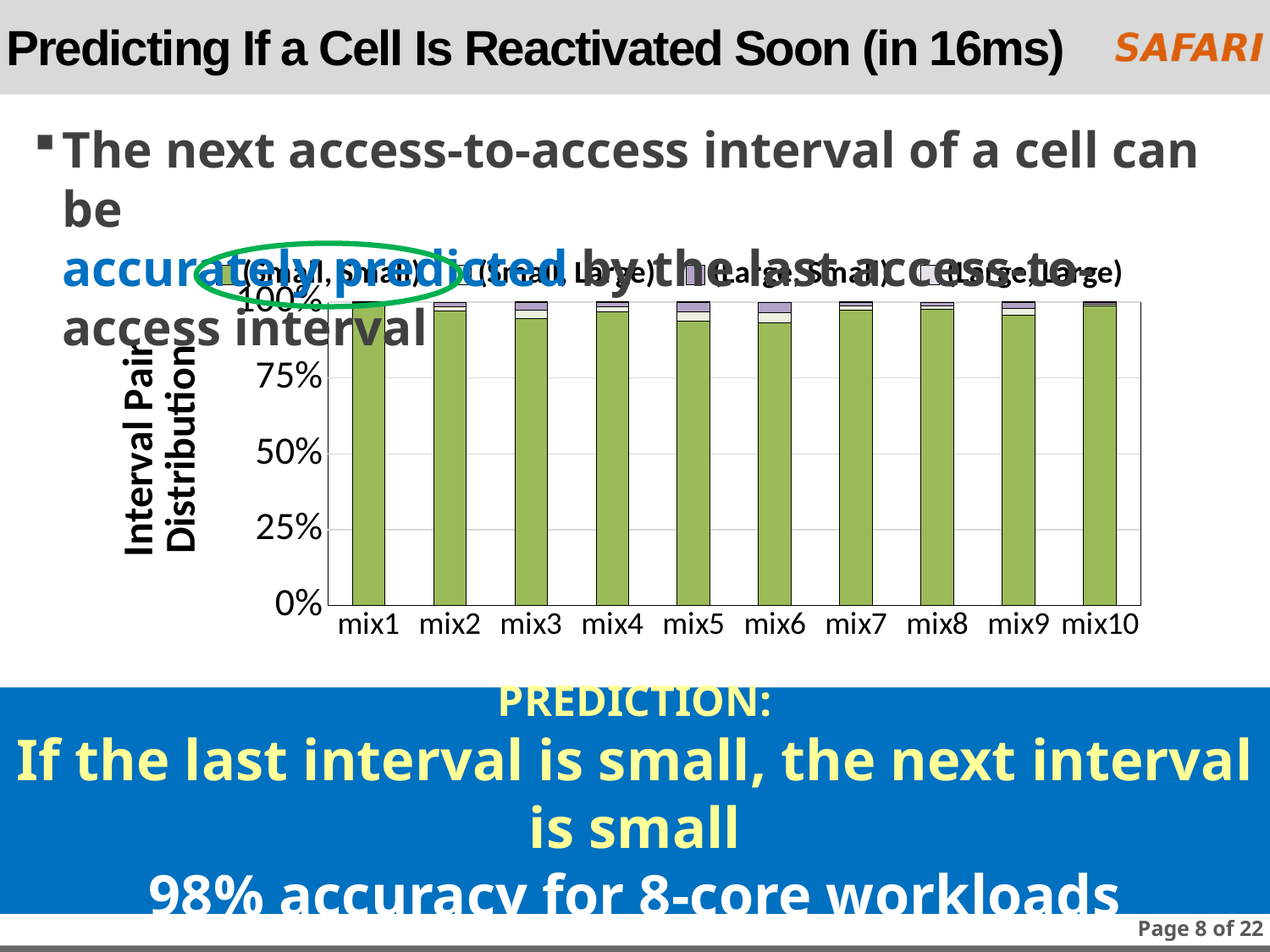
What is the label of the first category on the x axis? mix1 What is the total height of the stacked bar for mix1? 100% Is the (Small, Small) value for mix5 greater or less than 75%? greater Is the (Small, Small) value for mix10 greater or less than 50%? greater What is the label of the y axis of the chart? Interval Pair Distribution Is the (Small, Small) value for mix1 greater or less than 75%? greater How many workload mixes (categories) are shown on the x axis of the chart? 10 What is the highest tick value shown on the y axis of the chart? 100% How many series does the chart's legend list? 4 Which legend entry is plotted in green in the chart? (Small, Small) What kind of chart is shown on the slide? bar chart